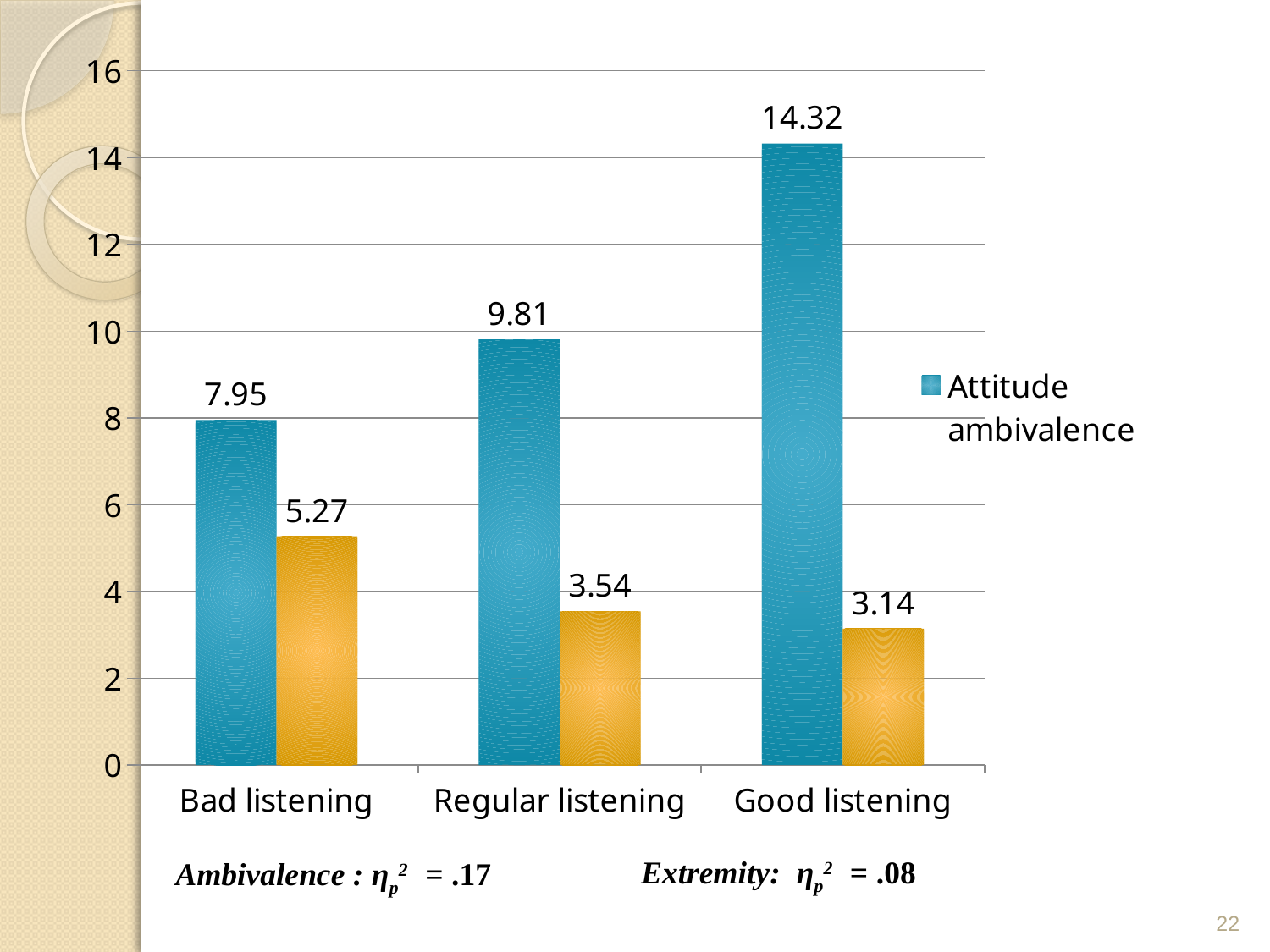
Do the Attitude ambivalence values rise or fall from Bad listening to Good listening? rise Which has a larger Attitude ambivalence value, Regular listening or Bad listening? Regular listening What is the Attitude ambivalence value for Bad listening? 7.95 What is the Attitude ambivalence value for Good listening? 14.32 How many categories are shown on the x axis? 3 Is the Attitude ambivalence value for Good listening greater or less than 14? greater Which category has the lowest value for the orange bars? Good listening What is the difference between the orange bar values for Bad listening and Good listening? 2.13 What kind of chart is shown on the slide? bar chart What is the difference between the Attitude ambivalence values for Good listening and Bad listening? 6.37 Which category has the highest Attitude ambivalence value? Good listening What is the value of the orange bar for Regular listening? 3.54